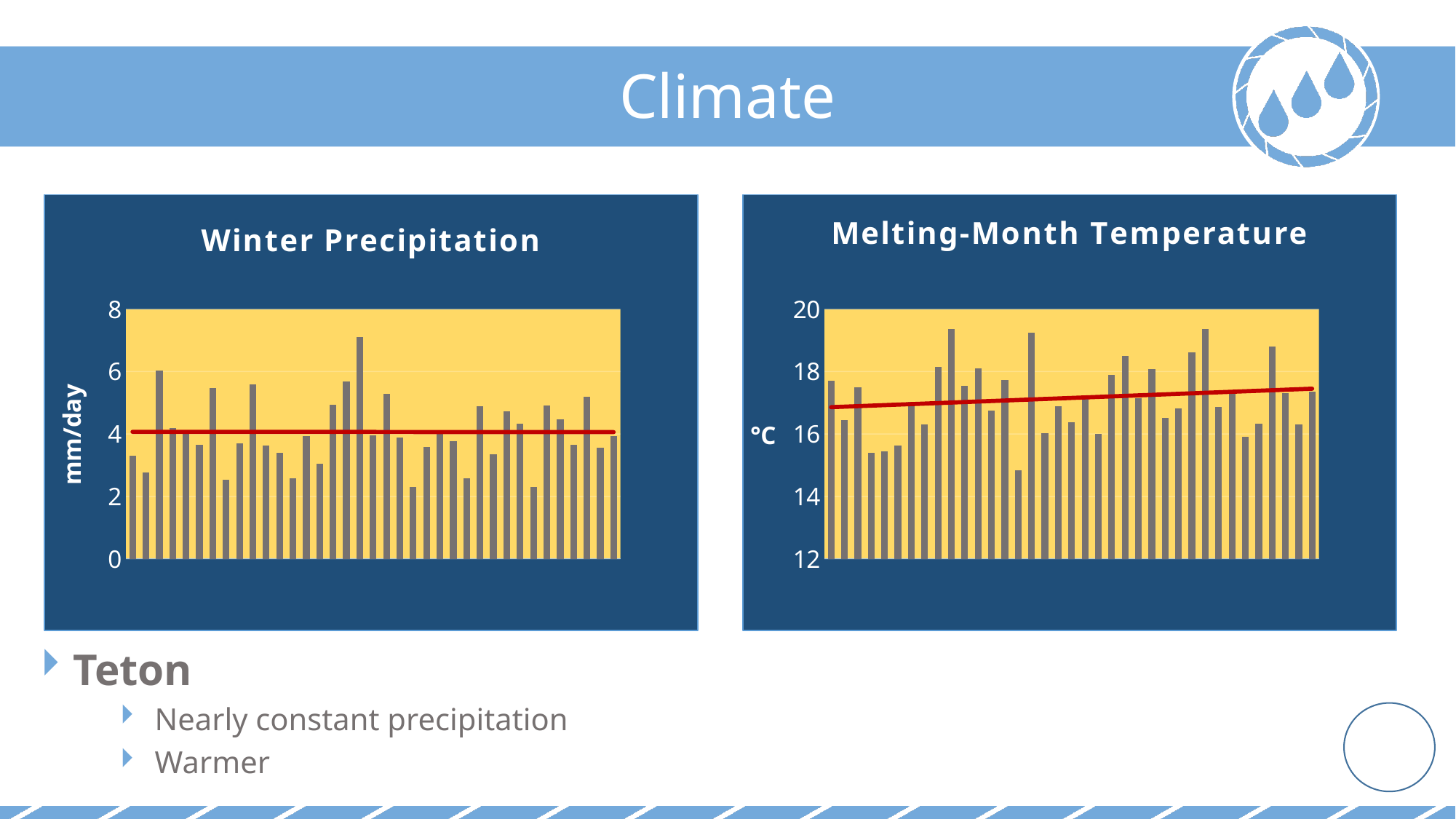
In the Winter Precipitation chart, is the shortest bar greater or less than 3 mm/day? less In the Melting-Month Temperature chart, is the shortest bar greater or less than 16 °C? less In the Melting-Month Temperature chart, what is the lowest value shown on the vertical axis? 12 In the Winter Precipitation chart, is the tallest bar greater or less than 6 mm/day? greater What kind of chart is the Melting-Month Temperature chart? Bar chart What kind of chart is the Winter Precipitation chart? Bar chart In the Melting-Month Temperature chart, does the red trend line rise or fall from left to right? Rise In the Winter Precipitation chart, does the red trend line rise, fall, or stay roughly flat from left to right? Roughly flat In the Melting-Month Temperature chart, what unit is shown on the vertical axis? °C In the Winter Precipitation chart, what is the highest value shown on the vertical axis? 8 In the Winter Precipitation chart, what unit is shown on the vertical axis? mm/day